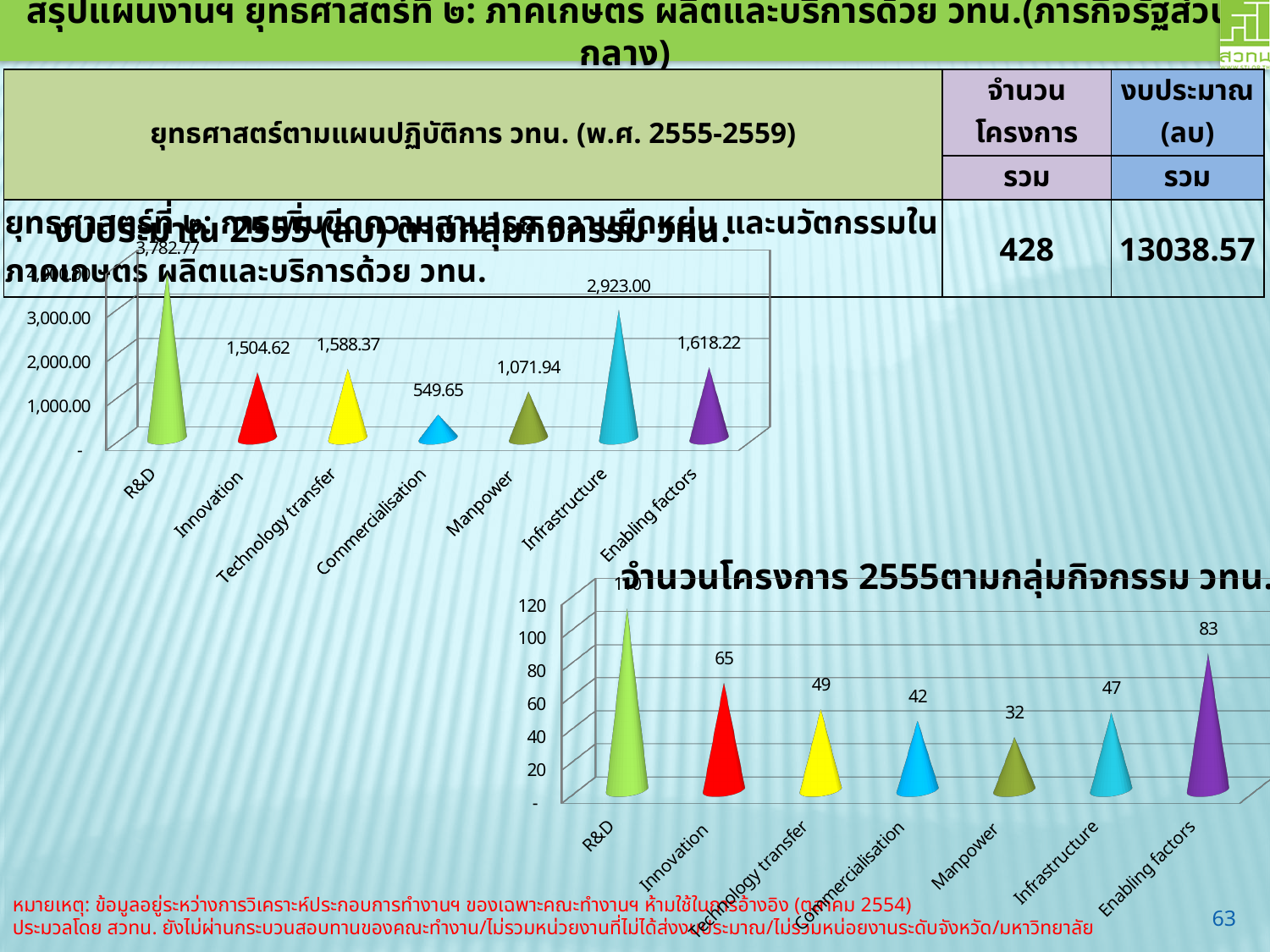
In the bottom chart (number of projects 2555 by activity group), what is the difference between the values for Innovation and Technology transfer? 16 In the top chart (budget 2555 by activity group), which is larger: the value for Technology transfer or the value for Innovation? Technology transfer In the top chart (budget 2555 by activity group), what is the value for Commercialisation? 549.65 In the top chart (budget 2555 by activity group), what is the difference between the values for Enabling factors and Manpower? 546.28 In the bottom chart (number of projects 2555 by activity group), what is the value for Enabling factors? 83 In the bottom chart (number of projects 2555 by activity group), which category has the lowest value? Manpower In the top chart (budget 2555 by activity group), what is the value for Infrastructure? 2,923.00 In the bottom chart (number of projects 2555 by activity group), is the value for R&D greater or less than 100? greater How many categories are shown on the x axis of the bottom chart (number of projects 2555 by activity group)? 7 In the top chart (budget 2555 by activity group), which category has the highest value? R&D In the top chart (budget 2555 by activity group), which category has the lowest value? Commercialisation In the bottom chart (number of projects 2555 by activity group), what is the value for Manpower? 32